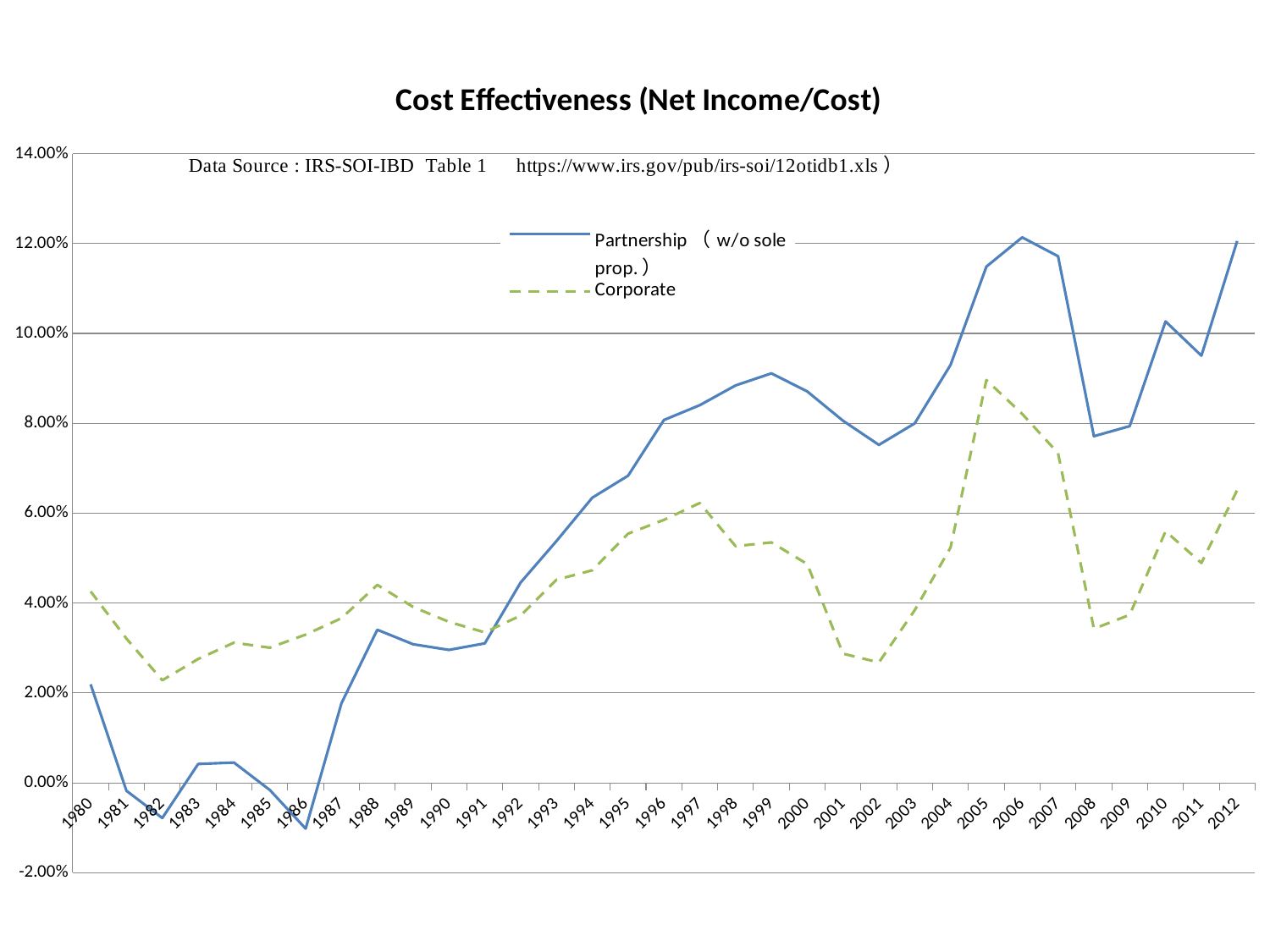
What kind of chart is shown on the slide? line chart Is the Partnership (w/o sole prop.) value for 2008 greater or less than 8.00%? less In 1980, which series has the higher value, Partnership (w/o sole prop.) or Corporate? Corporate How many series does the legend list? 2 Does the Partnership (w/o sole prop.) series generally rise or fall from 1986 to 1999? rise How many years are plotted along the x axis? 33 Is the Partnership (w/o sole prop.) value for 2005 greater or less than 10.00%? greater In 2005, which series has the higher value, Partnership (w/o sole prop.) or Corporate? Partnership (w/o sole prop.) In which year does the Corporate series reach its highest value? 2005 Is the Corporate value for 2002 greater or less than 4.00%? less What is the title of the chart? Cost Effectiveness (Net Income/Cost)